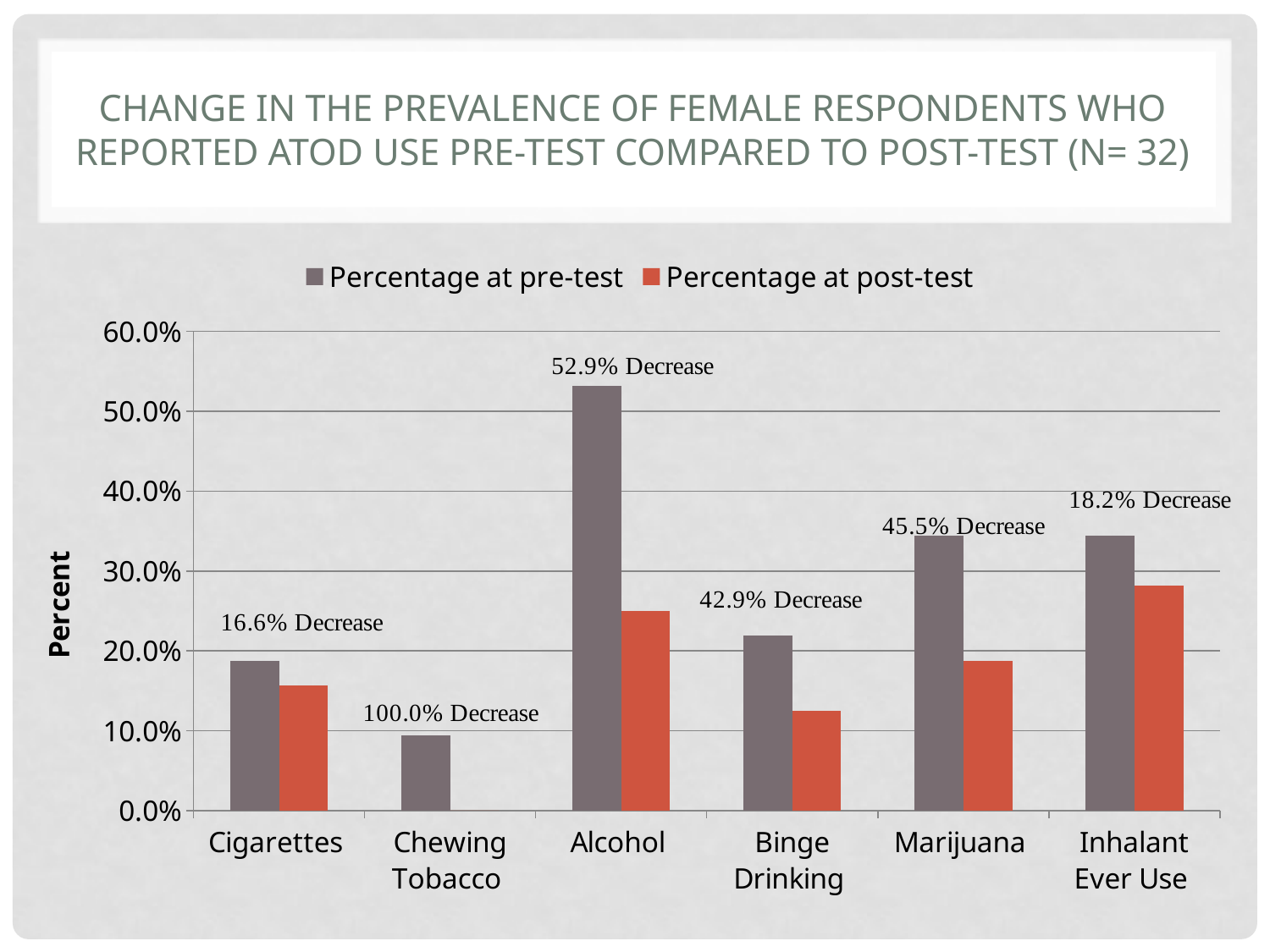
What kind of chart is shown on the slide? bar chart What decrease is annotated above the Alcohol bars? 52.9% Decrease How many categories are shown on the x axis? 6 Is the pre-test percentage for Cigarettes greater or less than 20.0%? less Which category has the highest pre-test percentage? Alcohol How many series does the legend list? 2 What decrease is annotated above the Inhalant Ever Use bars? 18.2% Decrease What is the label on the vertical axis? Percent Which category has the lowest pre-test percentage? Chewing Tobacco What decrease is annotated above the Chewing Tobacco bar? 100.0% Decrease Which is larger, the pre-test percentage for Alcohol or the pre-test percentage for Marijuana? Alcohol Is the pre-test percentage for Alcohol greater or less than 50.0%? greater